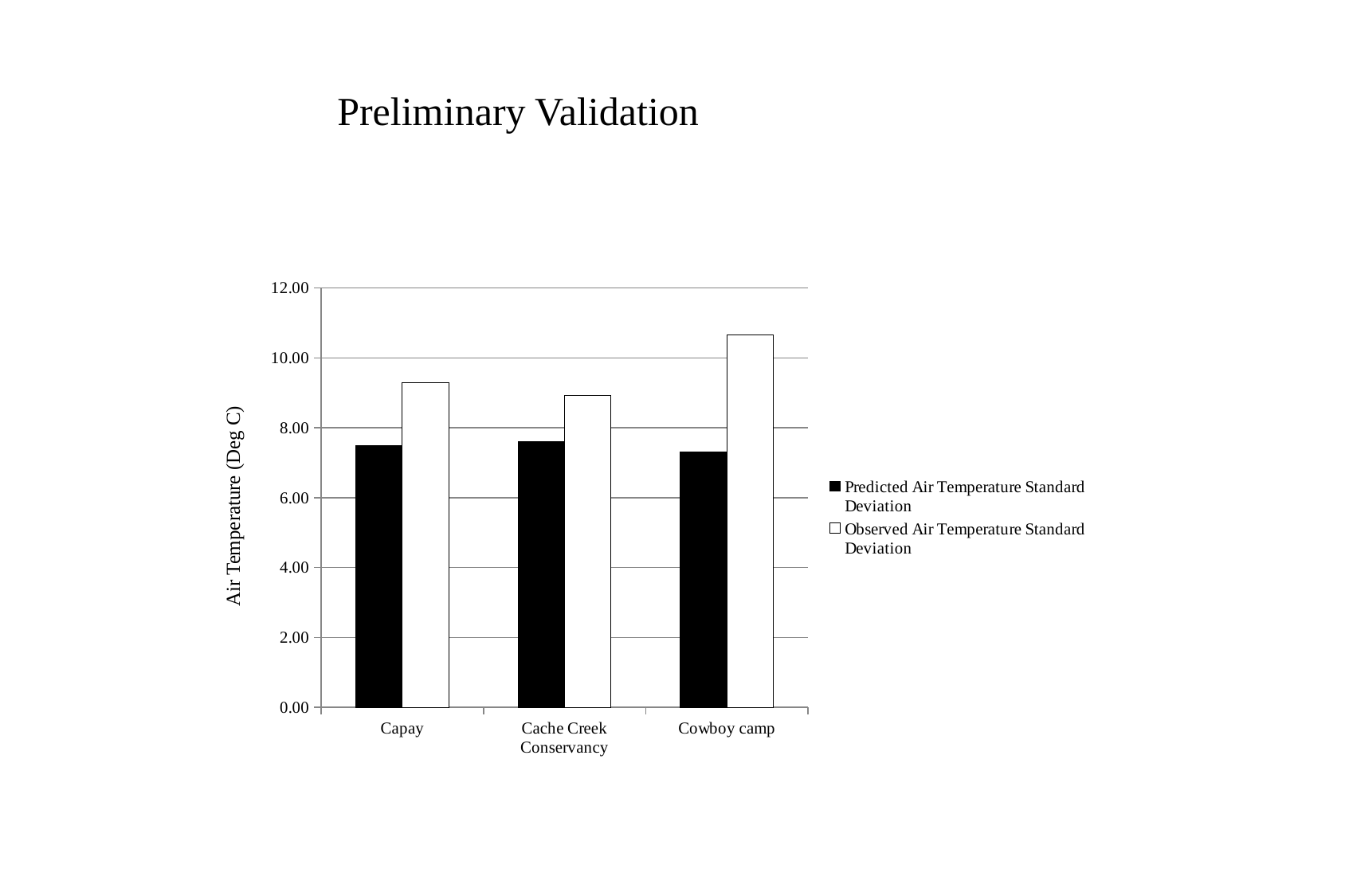
Is the Predicted Air Temperature Standard Deviation for Capay greater or less than 8.00? less For Capay, which is larger: the Predicted or the Observed Air Temperature Standard Deviation? Observed Air Temperature Standard Deviation Is the Predicted Air Temperature Standard Deviation for Cowboy camp greater or less than 6.00? greater How many series does the legend list? 2 Which category has the highest Observed Air Temperature Standard Deviation? Cowboy camp What kind of chart is shown on the slide? bar chart Which is larger: the Observed Air Temperature Standard Deviation for Cowboy camp or for Capay? Cowboy camp Is the Observed Air Temperature Standard Deviation for Cowboy camp greater or less than 10.00? greater Which category has the lowest Observed Air Temperature Standard Deviation? Cache Creek Conservancy What is the label of the y axis? Air Temperature (Deg C) How many categories are shown on the x axis? 3